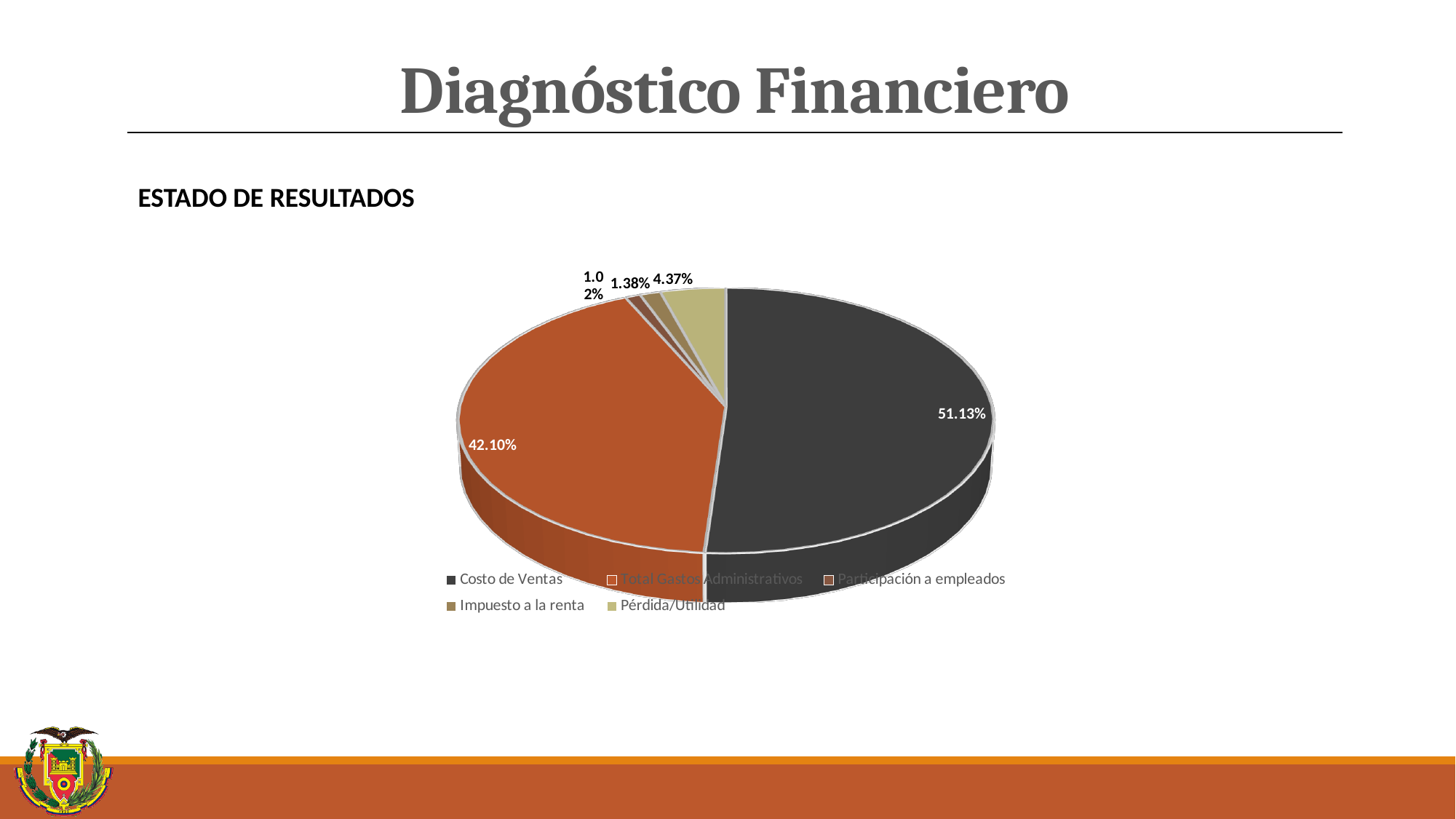
What is the heading shown above the chart? ESTADO DE RESULTADOS What share of the pie does Costo de Ventas represent? 51.13% Which is larger, the slice for Costo de Ventas or the slice for Total Gastos Administrativos? Costo de Ventas What is the difference between the Costo de Ventas share and the Total Gastos Administrativos share? 9.03% What share of the pie does Pérdida/Utilidad represent? 4.37% Which category has the largest slice of the pie? Costo de Ventas What colour is the Costo de Ventas slice? Dark grey Which category has the smallest slice of the pie? Participación a empleados What share of the pie does Total Gastos Administrativos represent? 42.10% What share of the pie does Impuesto a la renta represent? 1.38% What kind of chart is shown on the slide? Pie chart How many categories does the legend list? 5